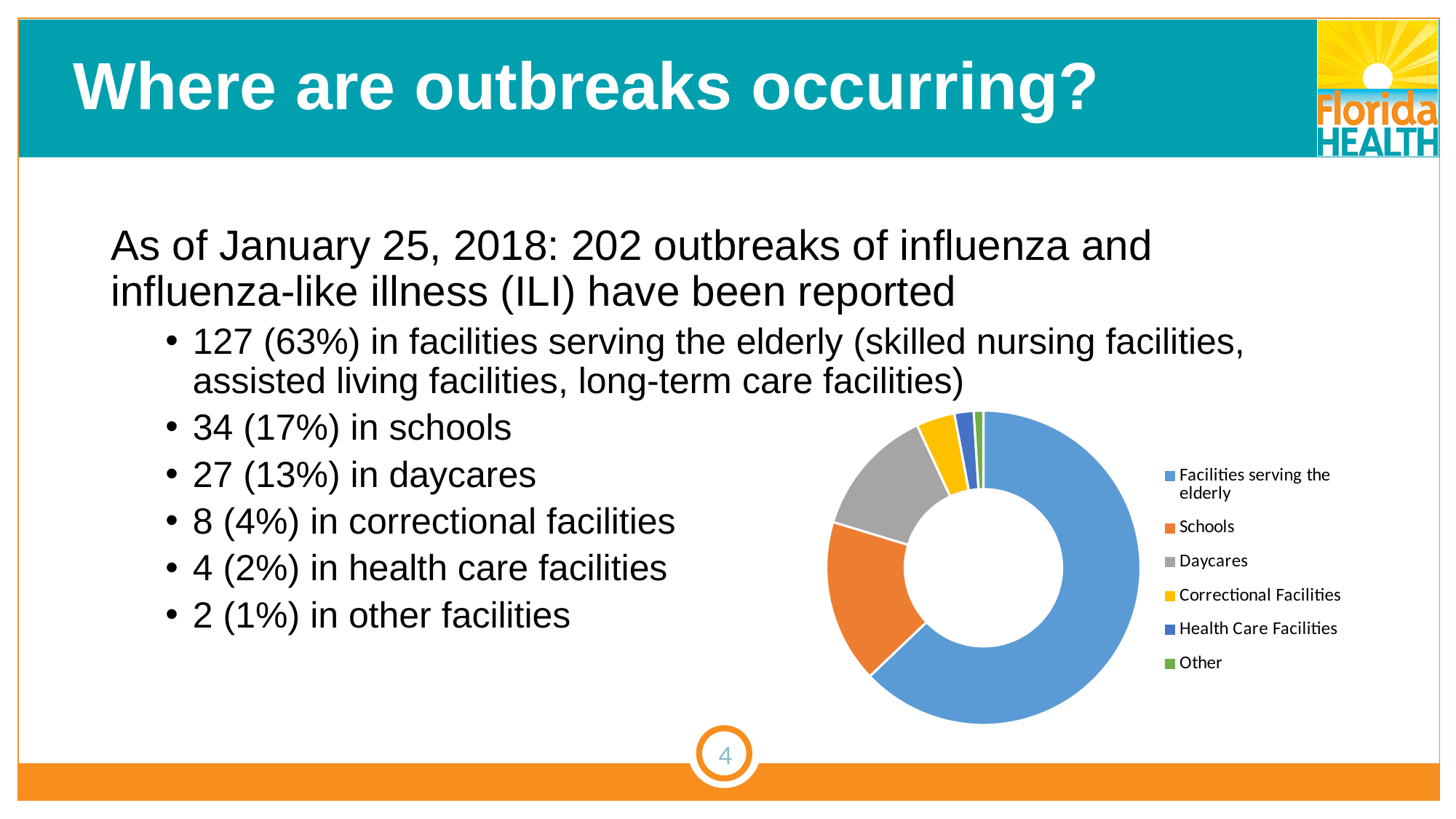
How many outbreaks are represented by the Daycares slice? 27 What share of outbreaks does the Facilities serving the elderly slice represent? 63% Which category has the largest slice in the chart? Facilities serving the elderly How many categories does the chart's legend list? 6 What kind of chart is shown on the slide? doughnut chart What is the difference in outbreaks between Facilities serving the elderly and Schools? 93 What share of outbreaks does the Schools slice represent? 17% Which slice is larger, Correctional Facilities or Health Care Facilities? Correctional Facilities Which category has the smallest slice in the chart? Other Which slice is larger, Schools or Daycares? Schools What colour is the Daycares slice in the chart? gray How many outbreaks are represented by the Correctional Facilities slice? 8